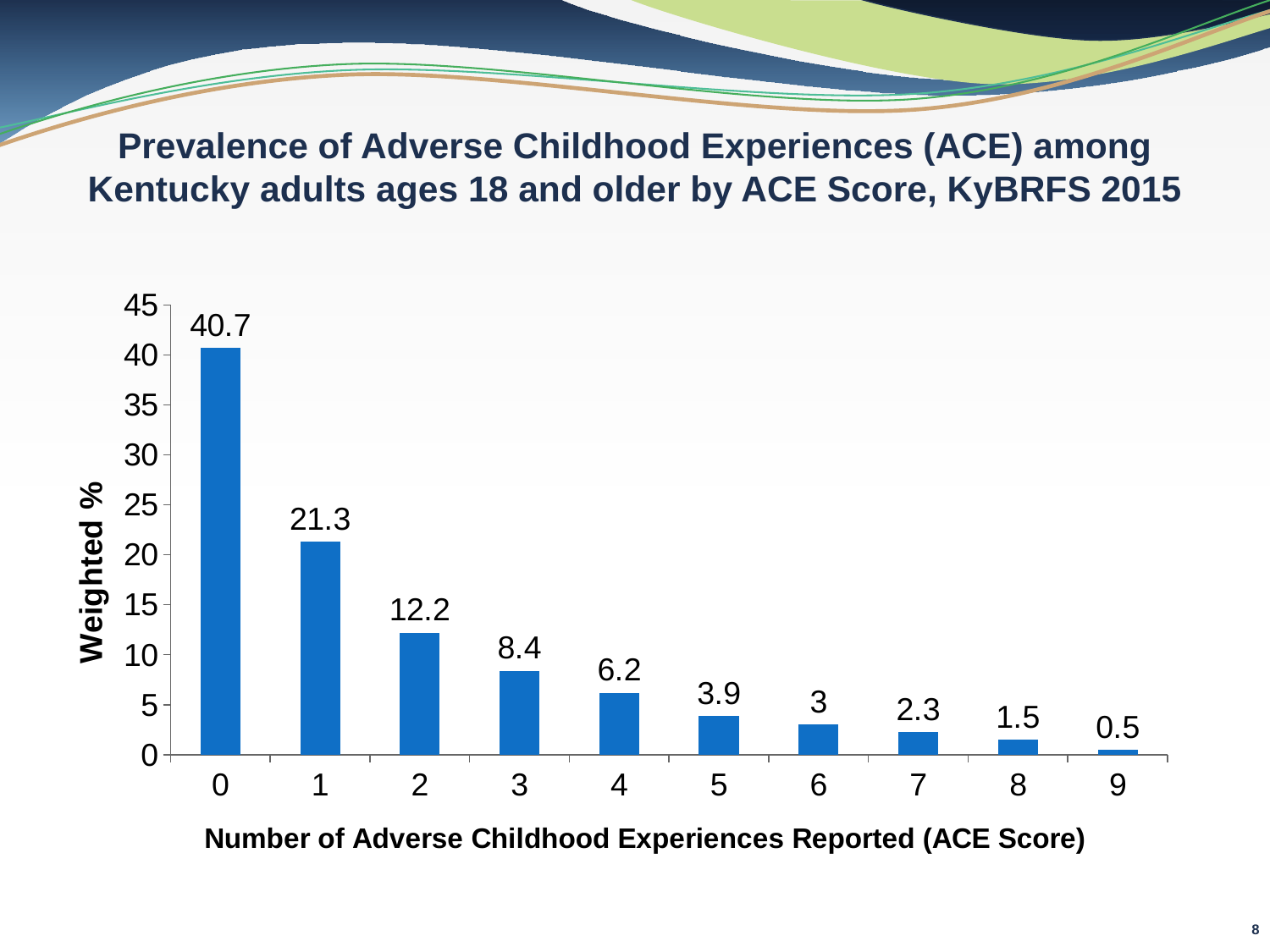
How many ACE score categories are shown on the x axis? 10 Which has a larger weighted %, ACE score 5 or ACE score 7? ACE score 5 What is the weighted % for an ACE score of 6? 3 What is the weighted % for an ACE score of 0? 40.7 Which ACE score has the lowest weighted %? 9 What kind of chart is shown on the slide? Bar chart What is the weighted % for an ACE score of 3? 8.4 What is the difference in weighted % between ACE score 2 and ACE score 4? 6 Which ACE score has the highest weighted %? 0 Do the weighted % values rise or fall as the ACE score increases from 0 to 9? Fall Is the weighted % for ACE score 1 greater or less than 20? greater What is the difference in weighted % between ACE score 0 and ACE score 1? 19.4